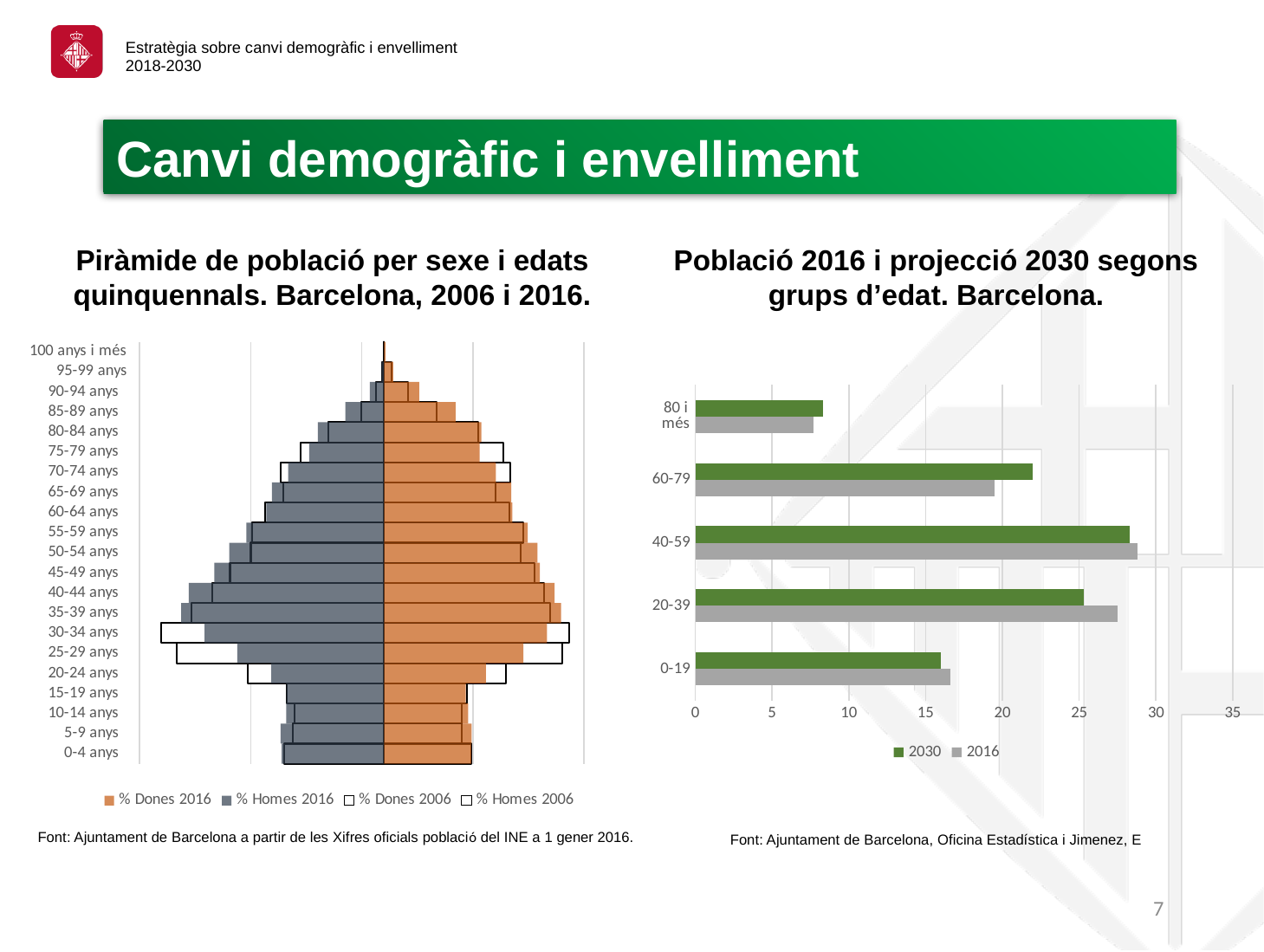
How many series does the legend list in the chart 'Població 2016 i projecció 2030 segons grups d'edat. Barcelona.'? 2 What kind of chart is the chart titled 'Població 2016 i projecció 2030 segons grups d'edat. Barcelona.'? bar chart In the chart 'Població 2016 i projecció 2030 segons grups d'edat. Barcelona.', is the 2030 value for 60-79 greater or less than 20? greater In the chart 'Població 2016 i projecció 2030 segons grups d'edat. Barcelona.', which age group has the highest value for 2030? 40-59 In the chart 'Població 2016 i projecció 2030 segons grups d'edat. Barcelona.', which age group has the lowest value for 2030? 80 i més In the chart 'Població 2016 i projecció 2030 segons grups d'edat. Barcelona.', is the 2016 value for 20-39 greater or less than 25? greater How many age-group categories are shown in the chart 'Població 2016 i projecció 2030 segons grups d'edat. Barcelona.'? 5 In the chart 'Població 2016 i projecció 2030 segons grups d'edat. Barcelona.', for the 20-39 group, which is larger: the 2030 value or the 2016 value? 2016 How many age-group categories are shown on the vertical axis of the chart 'Piràmide de població per sexe i edats quinquennals. Barcelona, 2006 i 2016.'? 21 In the chart 'Població 2016 i projecció 2030 segons grups d'edat. Barcelona.', for the 60-79 group, which is larger: the 2030 value or the 2016 value? 2030 In the chart 'Població 2016 i projecció 2030 segons grups d'edat. Barcelona.', is the 2016 value for 80 i més greater or less than 10? less How many series does the legend list in the chart 'Piràmide de població per sexe i edats quinquennals. Barcelona, 2006 i 2016.'? 4